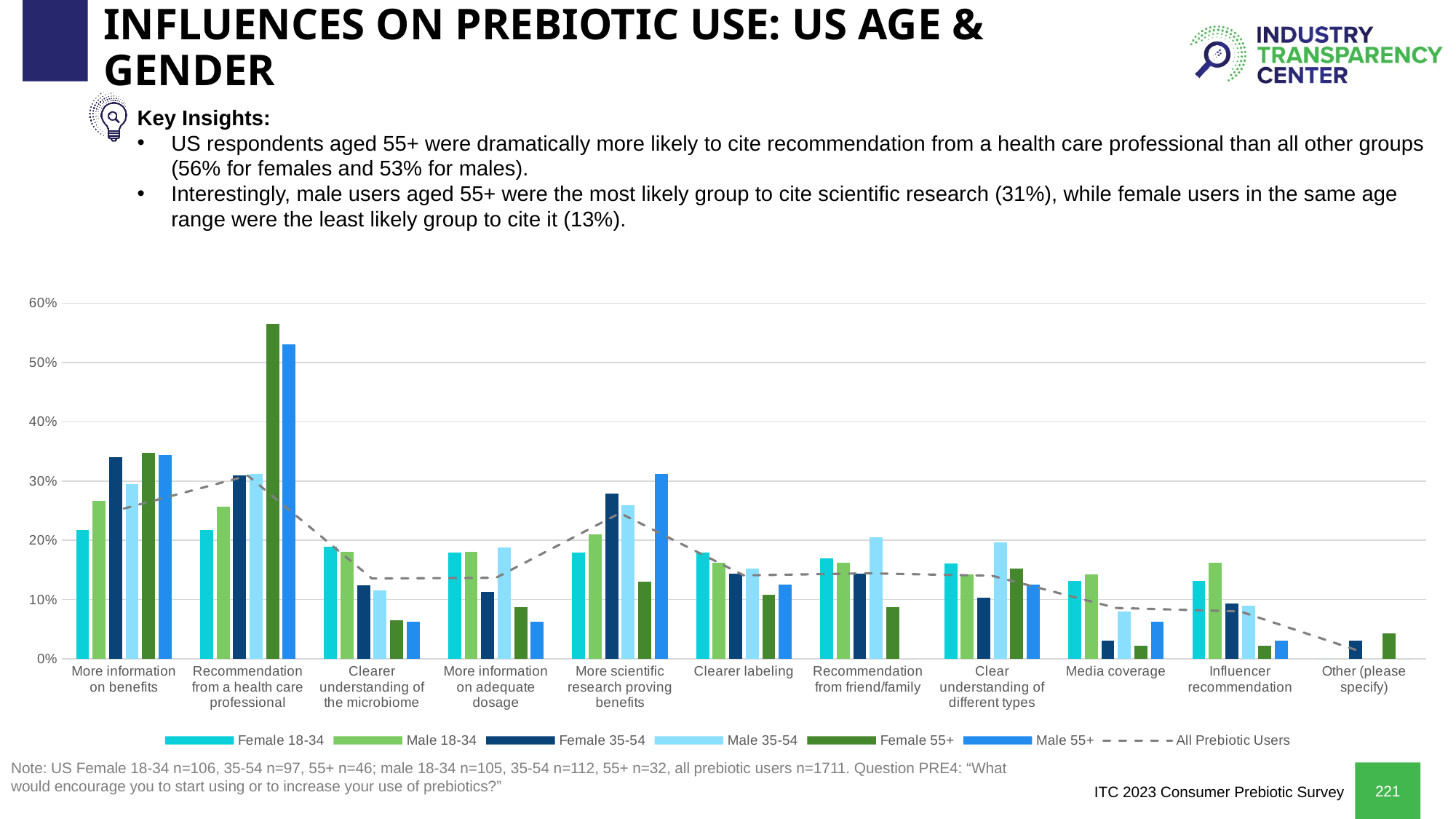
What is the value for Female 55+ for 'More scientific research proving benefits'? 13% What is the difference between the Male 55+ and Female 55+ values for 'More scientific research proving benefits'? 18% Which group has the highest value for 'Recommendation from a health care professional'? Female 55+ What is the value for Male 55+ for 'More scientific research proving benefits'? 31% What is the value for Male 55+ for 'Recommendation from a health care professional'? 53% Which is larger for 'Media coverage': Female 18-34 or Female 35-54? Female 18-34 How many series does the chart legend list? 7 Which series in the legend is drawn as a dashed line rather than bars? All Prebiotic Users What type of chart is shown on the slide? combination bar and line chart Is the value for Female 18-34 for 'More information on benefits' greater or less than 30%? less What is the value for Female 55+ for 'Recommendation from a health care professional'? 56% How many categories are shown along the x axis of the chart? 11